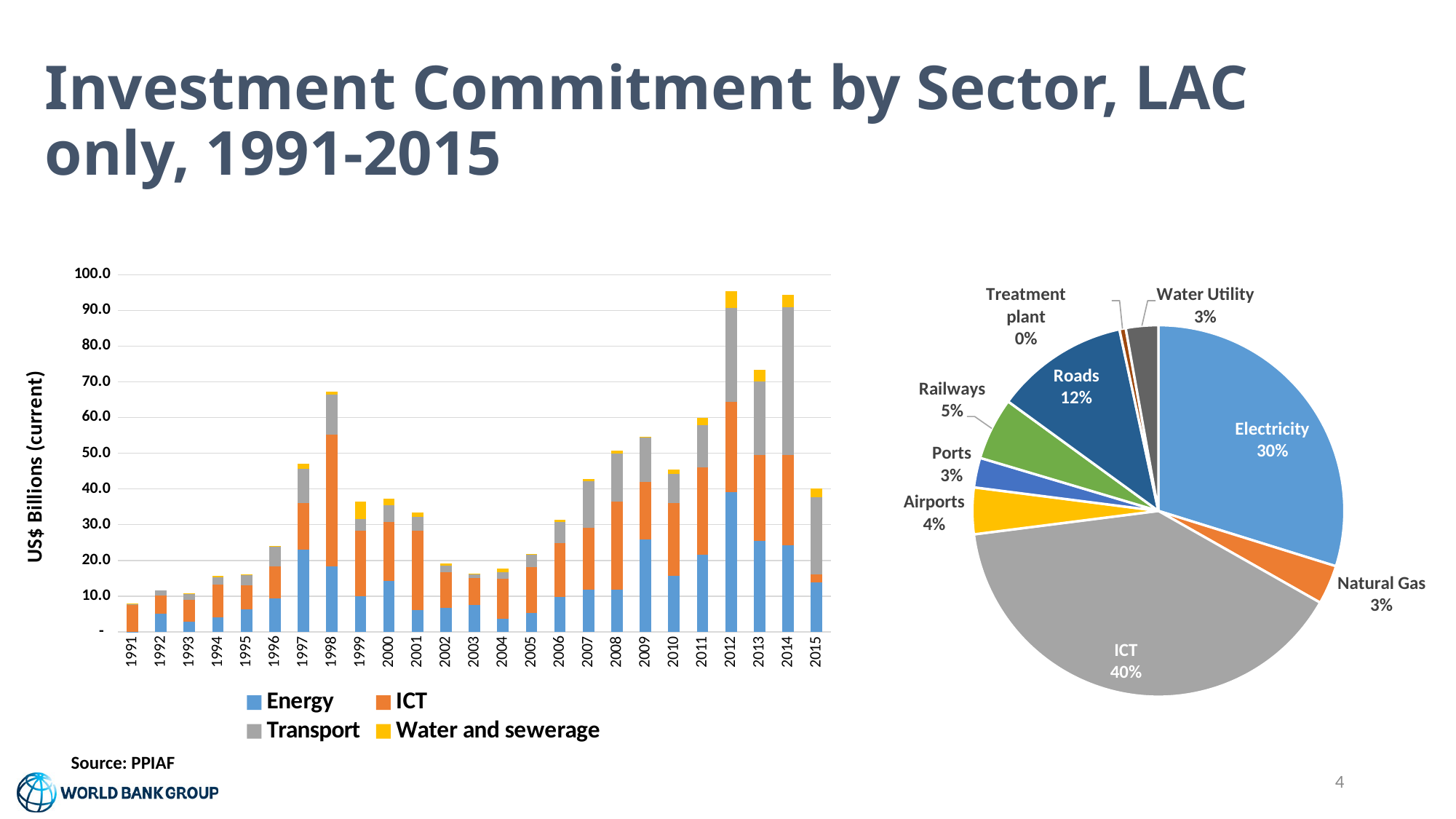
In the pie chart on the right, which sector has the smallest share? Treatment plant In the bar chart on the left, which year has the lowest total investment commitment? 1991 How many series does the legend of the bar chart on the left list? 4 In the pie chart on the right, which is larger, the share for Railways or the share for Airports? Railways In the bar chart on the left, is the total value for 1998 greater or less than 60.0? greater In the pie chart on the right, what share does Roads have? 12% In the pie chart on the right, how many percentage points larger is ICT's share than Electricity's share? 10 In the pie chart on the right, what share does Electricity have? 30% In the pie chart on the right, how many sectors are shown? 9 What kind of chart is the chart on the left? Stacked bar chart In the pie chart on the right, which sector has the largest share? ICT In the pie chart on the right, what share does ICT have? 40%